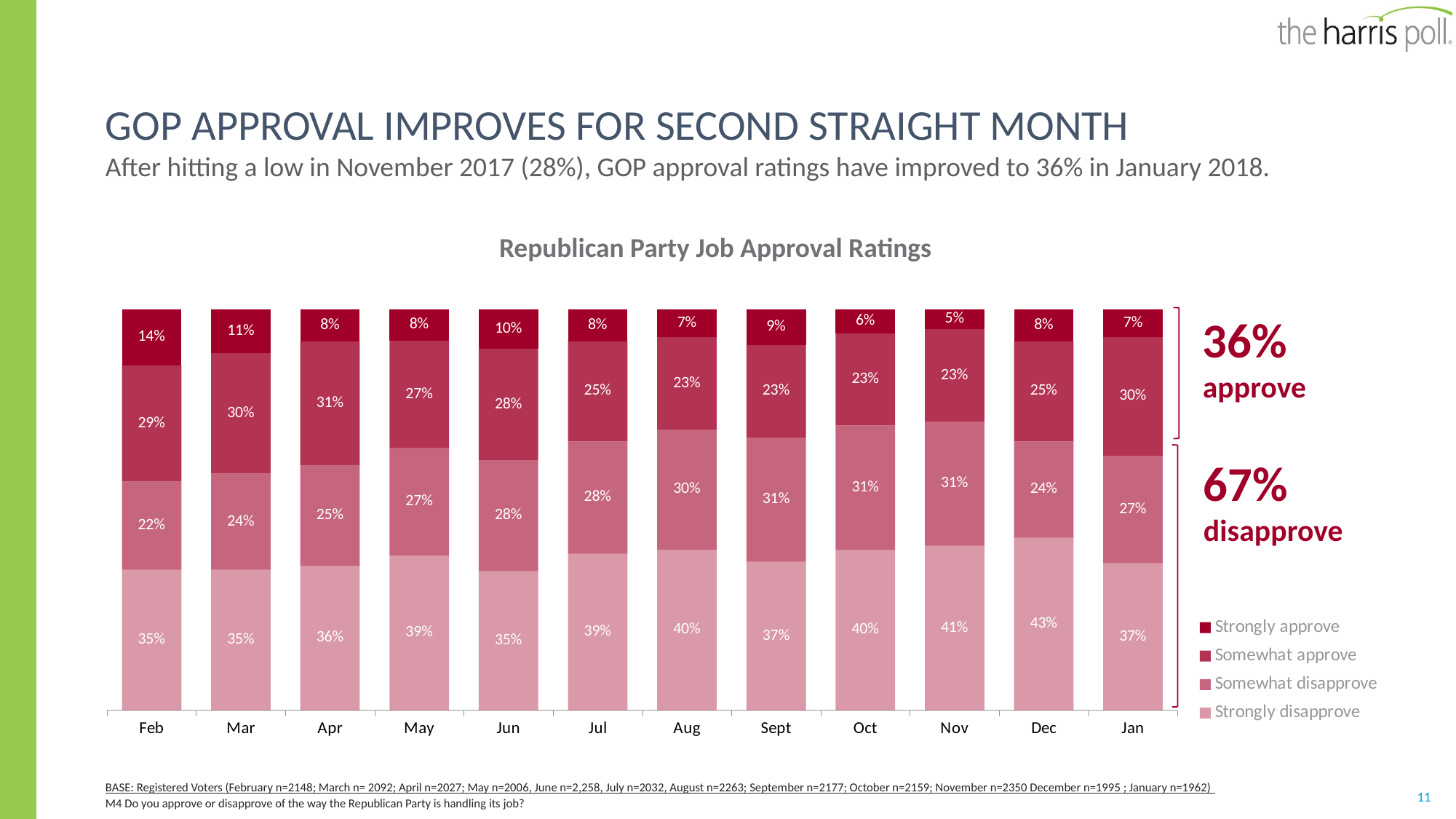
How many series does the legend list? 4 What is the title of the chart? Republican Party Job Approval Ratings In which month is the Strongly approve value highest? Feb Which month has the larger Somewhat disapprove value, Oct or Feb? Oct How many months are shown on the x axis? 12 What is the Strongly disapprove value for Dec? 43% What is the difference between the Somewhat approve values for Apr and Nov? 8 percentage points In which month is the Strongly approve value lowest? Nov In which month is the Strongly disapprove value highest? Dec What is the Strongly approve value for Feb? 14% What is the Somewhat approve value for Jan? 30% What kind of chart is shown? Stacked bar chart